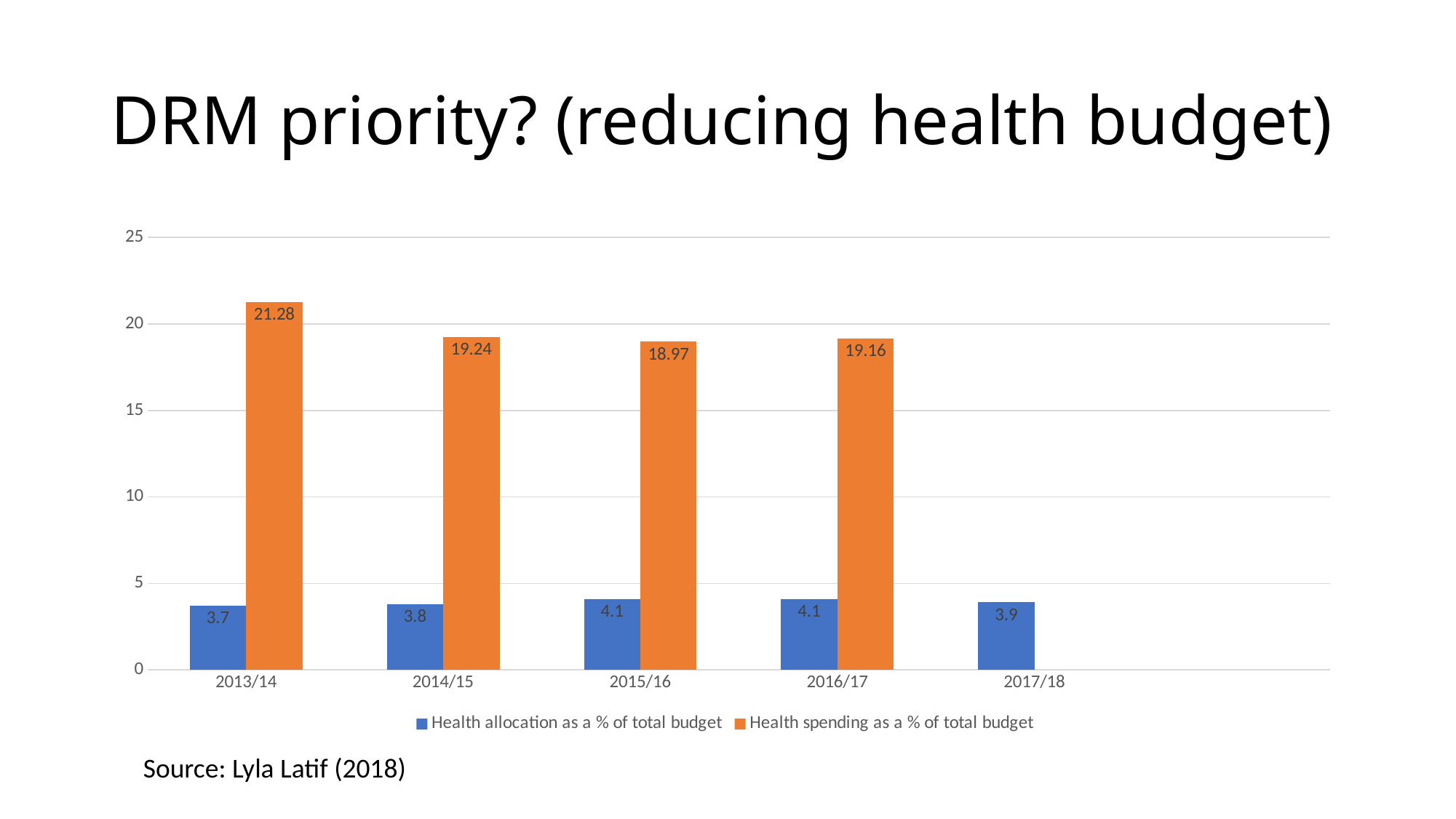
What kind of chart is shown on the slide? bar chart How many years are shown on the x axis? 5 Which year has the highest health spending as a % of total budget? 2013/14 Is the health spending as a % of total budget for 2013/14 greater or less than 20? greater Which is larger: health spending as a % of total budget in 2014/15 or in 2016/17? 2014/15 Which year has the lowest health spending as a % of total budget? 2015/16 What is the health allocation as a % of total budget for 2017/18? 3.9 Which colour represents health spending as a % of total budget? orange What is the difference between health spending and health allocation as a % of total budget in 2016/17? 15.06 How many series does the legend list? 2 What is the health spending as a % of total budget for 2014/15? 19.24 What is the health allocation as a % of total budget for 2013/14? 3.7